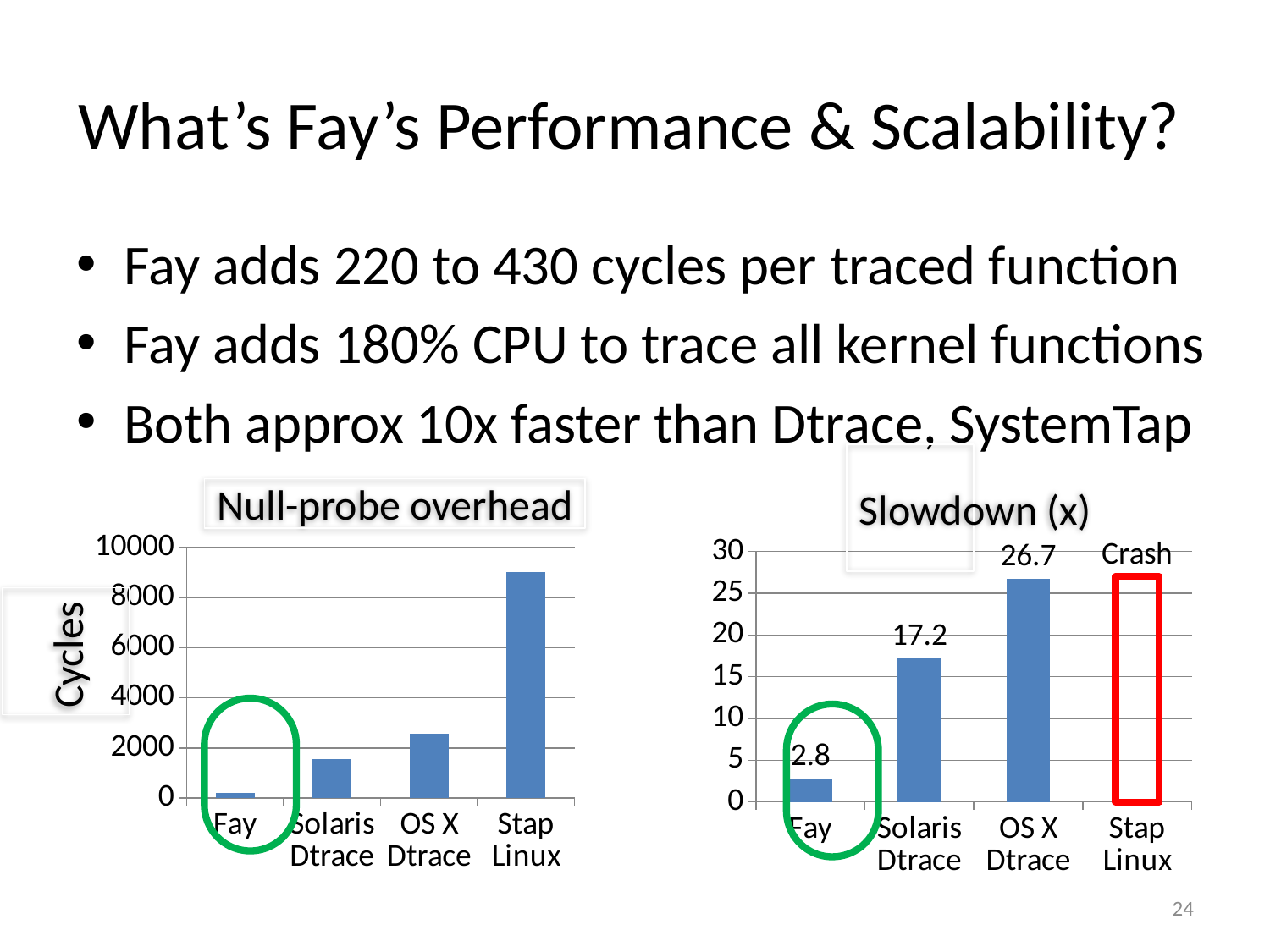
In the Slowdown (x) chart, what is the value for OS X Dtrace? 26.7 In the Slowdown (x) chart, what is the difference between Solaris Dtrace and Fay? 14.4 In the Null-probe overhead chart, is the value for OS X Dtrace greater or less than 2000? greater In the Slowdown (x) chart, what is the difference between OS X Dtrace and Solaris Dtrace? 9.5 In the Null-probe overhead chart, which category has the highest value? Stap Linux In the Slowdown (x) chart, what is the value for Fay? 2.8 In the Slowdown (x) chart, which category with a plotted bar has the highest value? OS X Dtrace In the Null-probe overhead chart, is the value for Stap Linux greater or less than 8000? greater In the Slowdown (x) chart, what label is shown for Stap Linux instead of a value? Crash In the Slowdown (x) chart, what is the value for Solaris Dtrace? 17.2 In the Null-probe overhead chart, which category has the lowest value? Fay What kind of chart is the Null-probe overhead chart? Bar chart